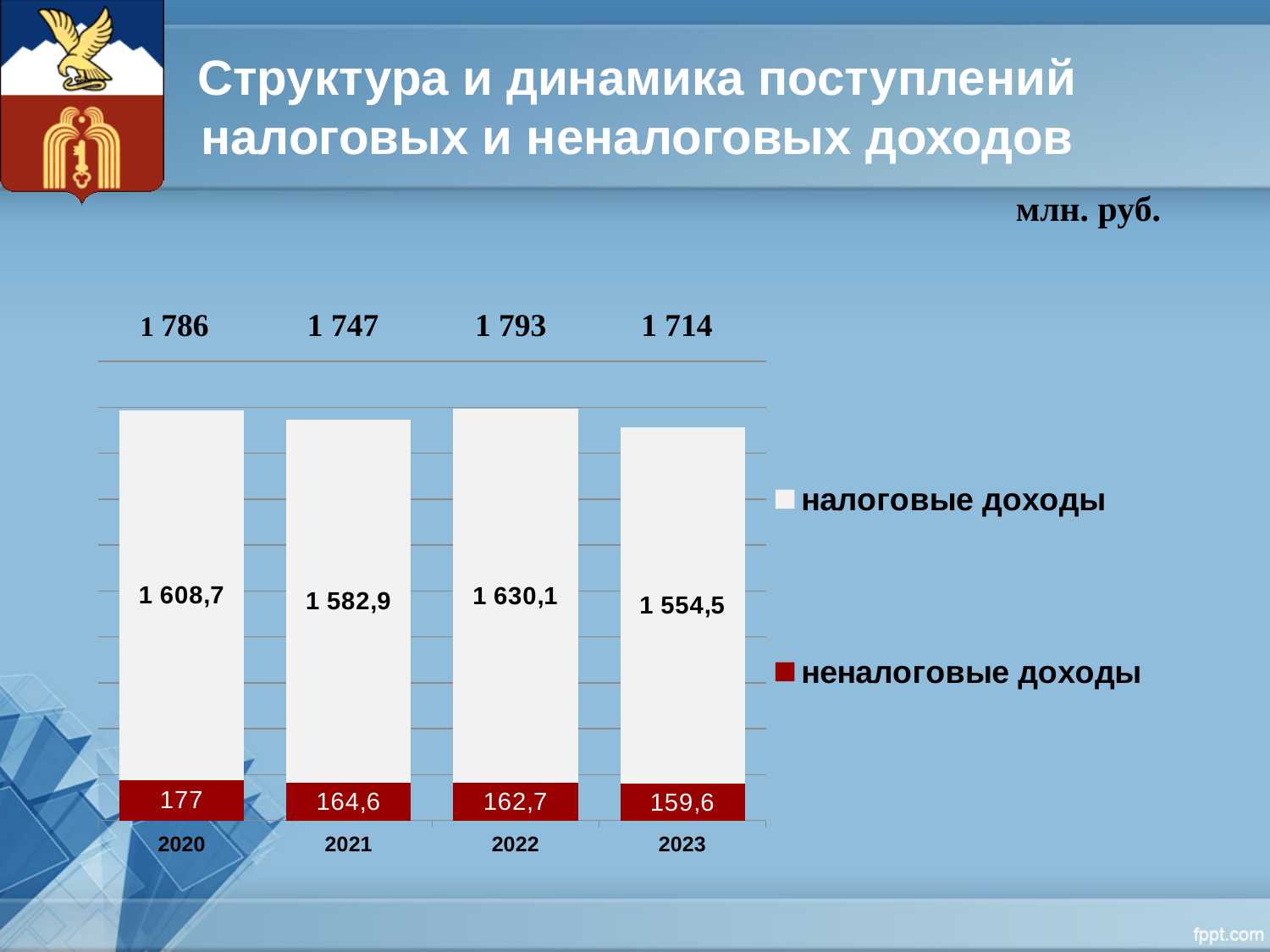
How many series does the legend list? 2 What is the difference between неналоговые доходы in 2020 and in 2023? 17,4 What is the value of налоговые доходы for 2022? 1 630,1 What is the value of неналоговые доходы for 2021? 164,6 How many years are shown on the x axis? 4 Which is larger: налоговые доходы in 2020 or in 2021? 2020 What is the value of неналоговые доходы for 2020? 177 What is the total shown above the bar for 2021? 1 747 Which year has the lowest value of неналоговые доходы? 2023 What type of chart is shown on the slide? stacked bar chart What is the value of налоговые доходы for 2023? 1 554,5 Which year has the highest value of налоговые доходы? 2022